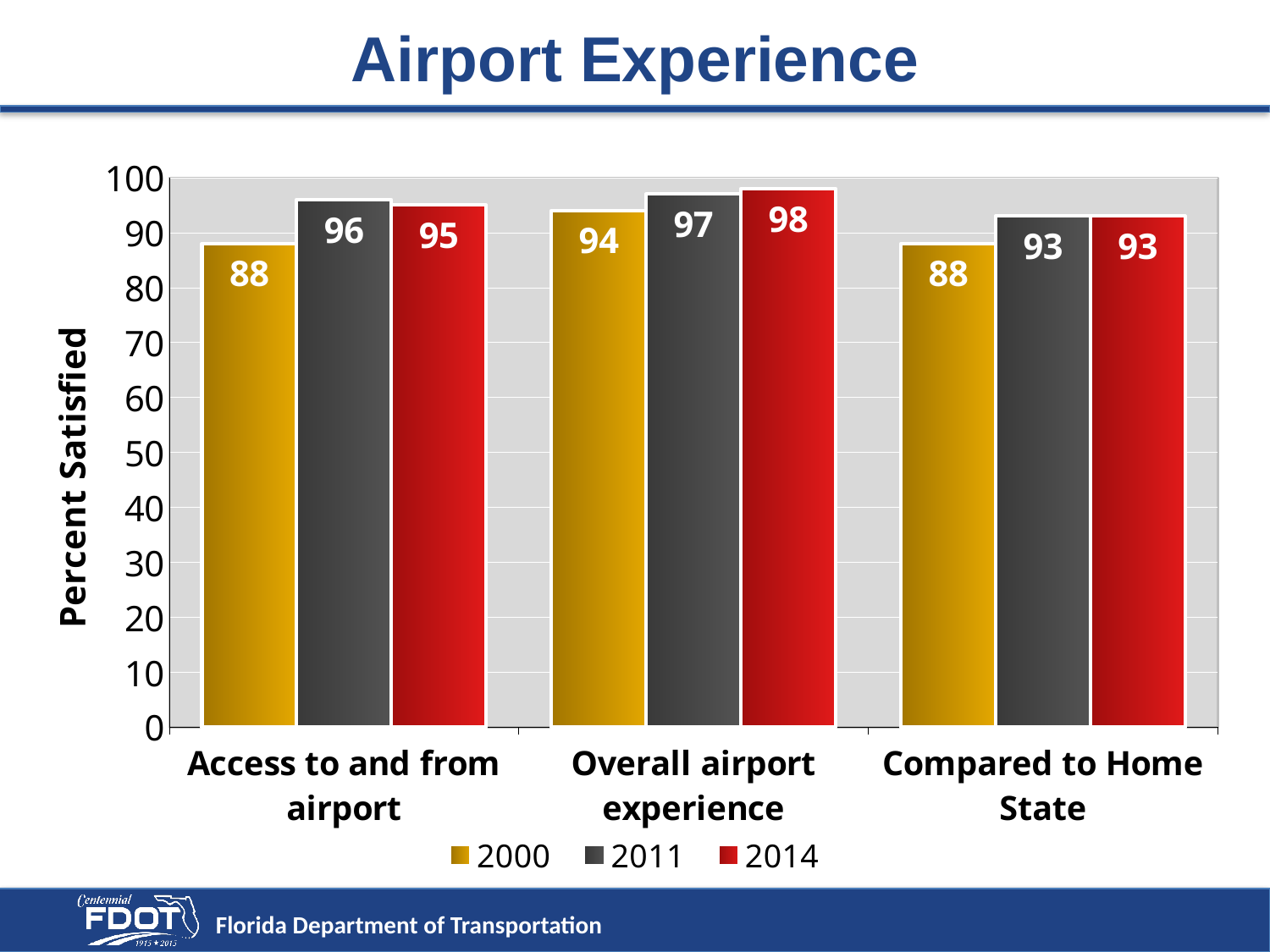
What is the label of the vertical axis? Percent Satisfied How many series does the legend list? 3 What is the 2000 value for Access to and from airport? 88 What is the 2014 value for Overall airport experience? 98 How many categories are shown on the x axis? 3 Which colour represents the 2014 series in the legend? Red What is the 2011 value for Compared to Home State? 93 Which category has the highest 2014 value? Overall airport experience What kind of chart is shown on the slide? Bar chart What is the difference between the 2011 and 2000 values for Access to and from airport? 8 Which category has the lowest 2011 value? Compared to Home State Which is larger for Overall airport experience, the 2000 value or the 2011 value? 2011